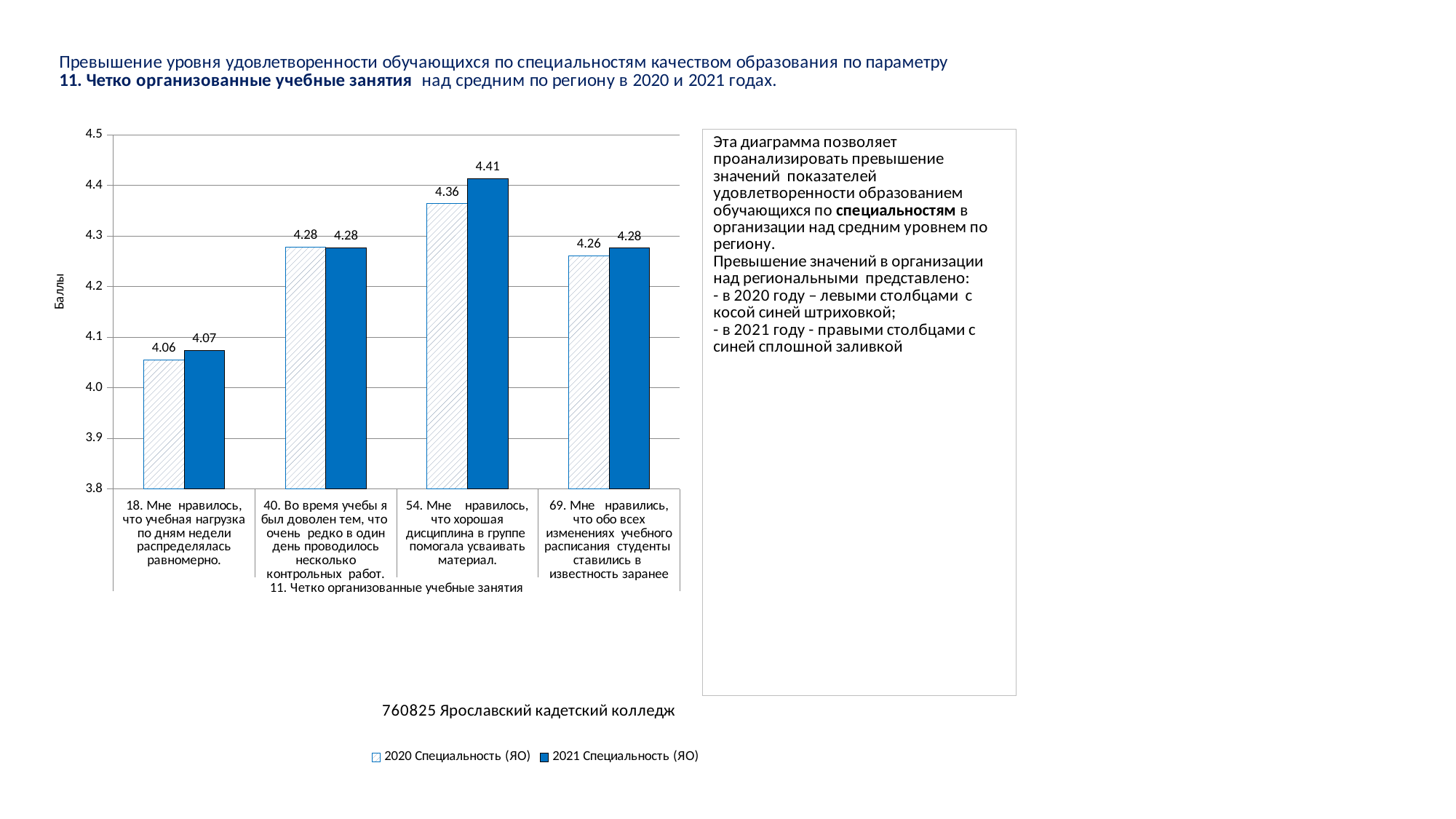
How many series does the legend list? 2 Which question has the highest 2021 Специальность (ЯО) value? 54. Мне нравилось, что хорошая дисциплина в группе помогала усваивать материал. How many question categories are shown on the x axis? 4 Which question has the lowest 2020 Специальность (ЯО) value? 18. Мне нравилось, что учебная нагрузка по дням недели распределялась равномерно. What is the label of the y axis? Баллы For question 40, is the 2020 value or the 2021 value larger, or are they equal? Equal (both 4.28) What is the 2021 Специальность (ЯО) value for question 54 (Мне нравилось, что хорошая дисциплина в группе помогала усваивать материал)? 4.41 What is the 2020 Специальность (ЯО) value for question 69 (Мне нравились, что обо всех изменениях учебного расписания студенты ставились в известность заранее)? 4.26 What is the difference between the 2021 and 2020 Специальность (ЯО) values for question 54? 0.05 What is the 2020 Специальность (ЯО) value for question 18 (Мне нравилось, что учебная нагрузка по дням недели распределялась равномерно)? 4.06 Is the 2021 Специальность (ЯО) value for question 18 greater or less than 4.1? less What type of chart is shown on the slide? Bar chart